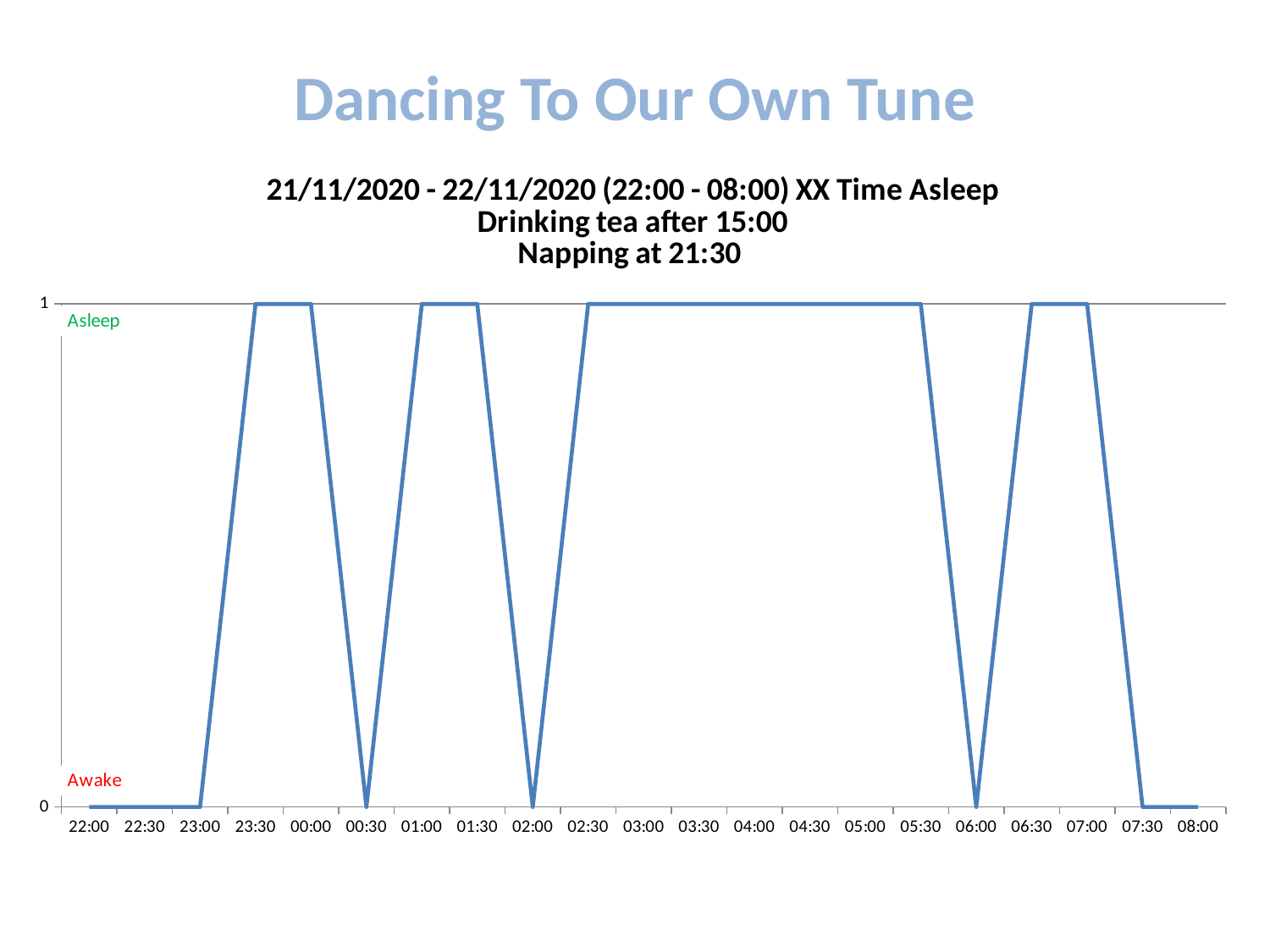
Does the line rise or fall between 07:00 and 07:30? fall What is the value at 23:30? 1 Does the line rise or fall between 23:00 and 23:30? rise How many time points are labelled on the x axis? 21 What label is shown next to the value 1 on the y axis? Asleep What is the value at 04:00? 1 What kind of chart is shown on the slide? line chart What label is shown next to the value 0 on the y axis? Awake What is the value at 00:30? 0 Which is larger, the value at 01:00 or the value at 02:00? 01:00 What is the value at 06:00? 0 What is the value at 08:00? 0